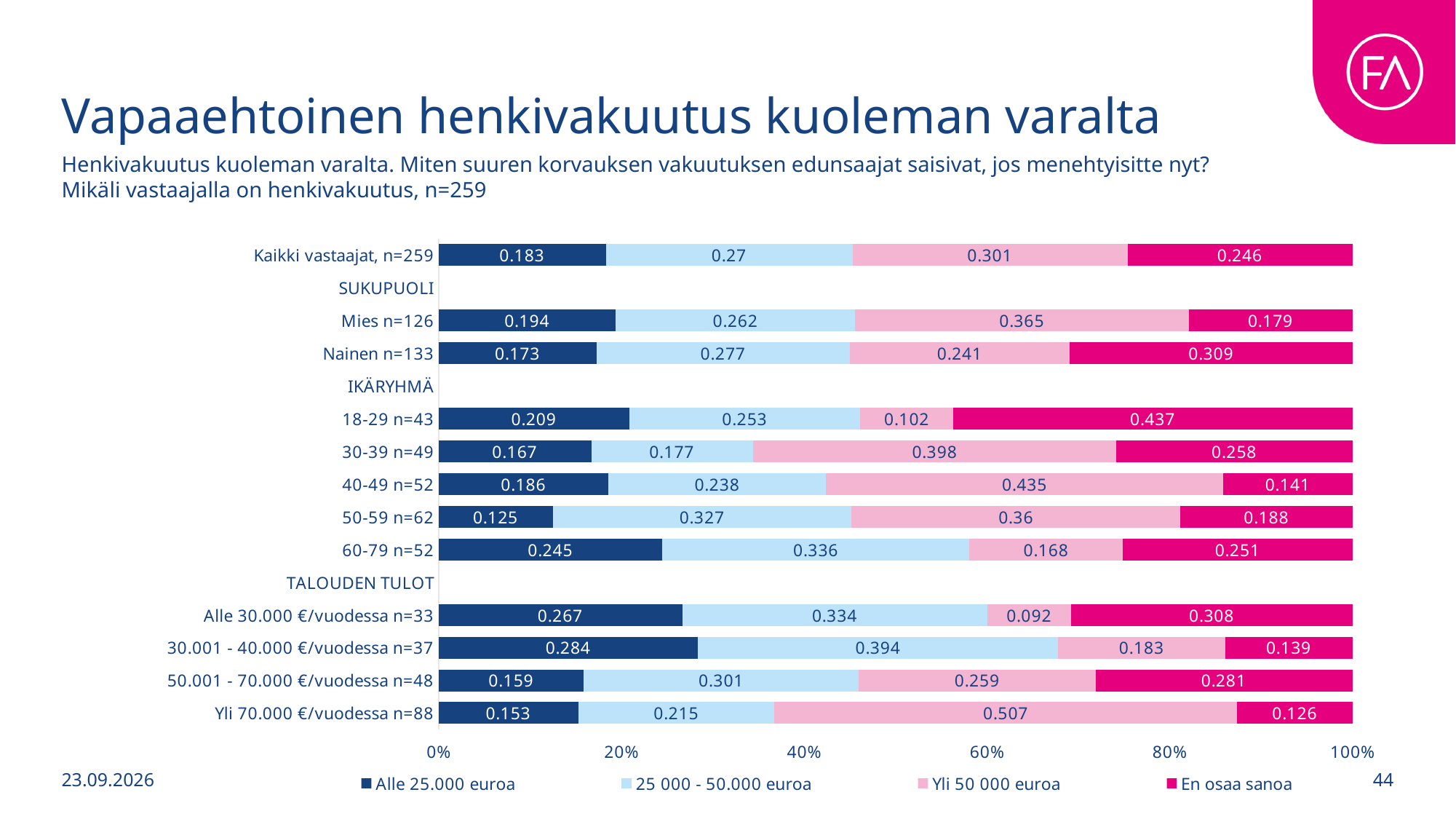
Which has the larger 'Yli 50 000 euroa' value: '30-39 n=49' or '40-49 n=52'? 40-49 n=52 What is the value for 'Yli 50 000 euroa' in the 'Mies n=126' bar? 0.365 How many categories have bars plotted in the chart? 12 Which category has the lowest value for 'Alle 25.000 euroa'? 50-59 n=62 What is the difference between the 'Alle 25.000 euroa' values for 'Mies n=126' and 'Nainen n=133'? 0.021 What kind of chart is shown on the slide? Stacked bar chart What is the value for '25 000 - 50.000 euroa' in the '30.001 - 40.000 €/vuodessa n=37' bar? 0.394 Which legend entry is shown in the darkest blue colour? Alle 25.000 euroa What is the value for 'Alle 25.000 euroa' in the 'Kaikki vastaajat, n=259' bar? 0.183 How many series does the legend list? 4 Which category has the highest value for 'Yli 50 000 euroa'? Yli 70.000 €/vuodessa n=88 What is the value for 'En osaa sanoa' in the '18-29 n=43' bar? 0.437